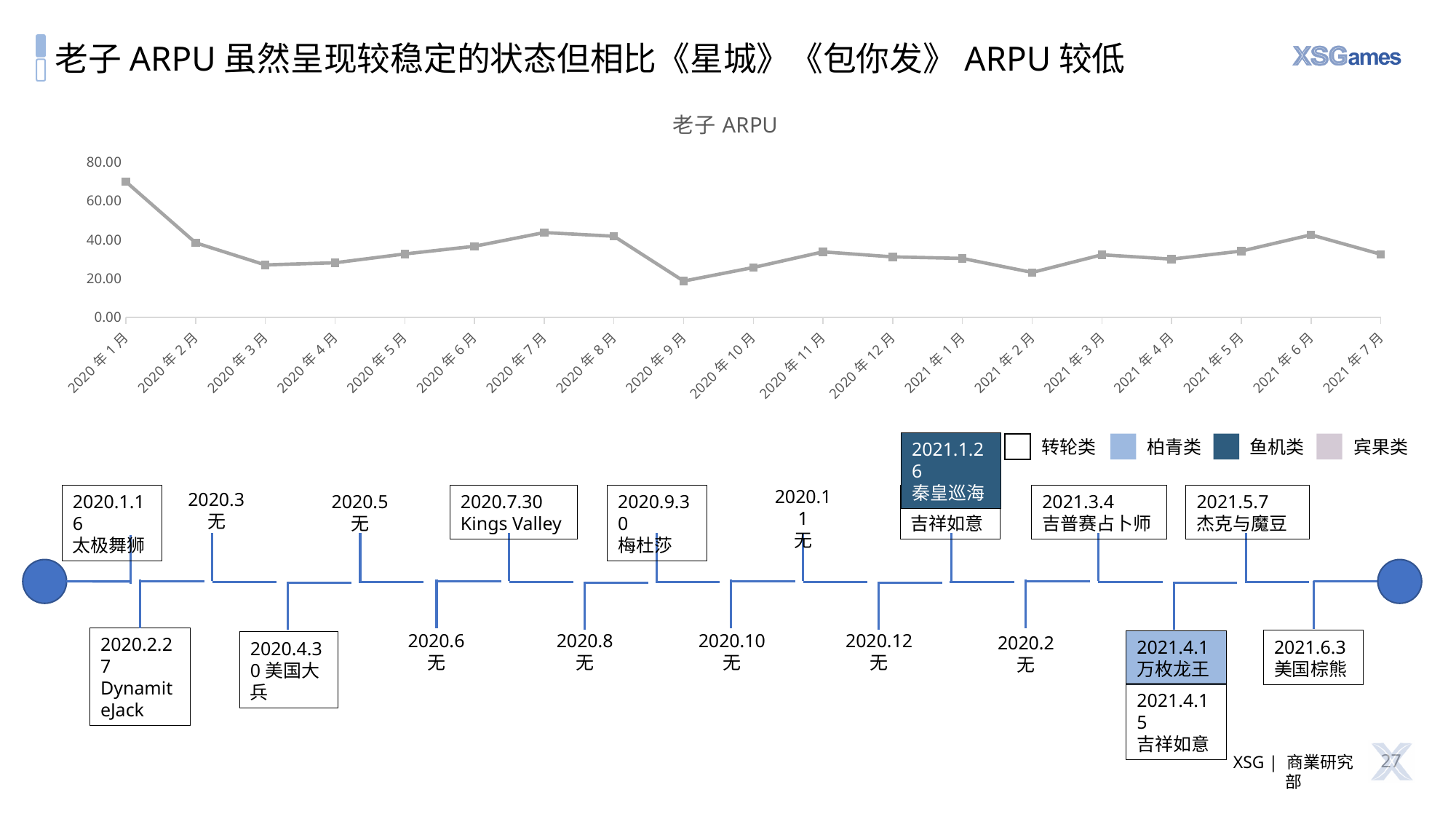
What is the highest value shown on the vertical axis of the 老子 ARPU chart? 80.00 Is the value for 2021 年 2 月 greater or less than 40.00? less What is the title of the chart on the slide? 老子 ARPU Does the ARPU rise or fall from 2020 年 1 月 to 2020 年 3 月? fall Which is larger, the ARPU for 2020 年 1 月 or for 2020 年 9 月? 2020 年 1 月 Which month has the lowest ARPU on the 老子 ARPU chart? 2020 年 9 月 Which month has the highest ARPU on the 老子 ARPU chart? 2020 年 1 月 What kind of chart is the 老子 ARPU chart? line chart Is the value for 2020 年 7 月 greater or less than 40.00? greater How many monthly data points are plotted on the 老子 ARPU chart? 19 Is the value for 2020 年 1 月 greater or less than 60.00? greater